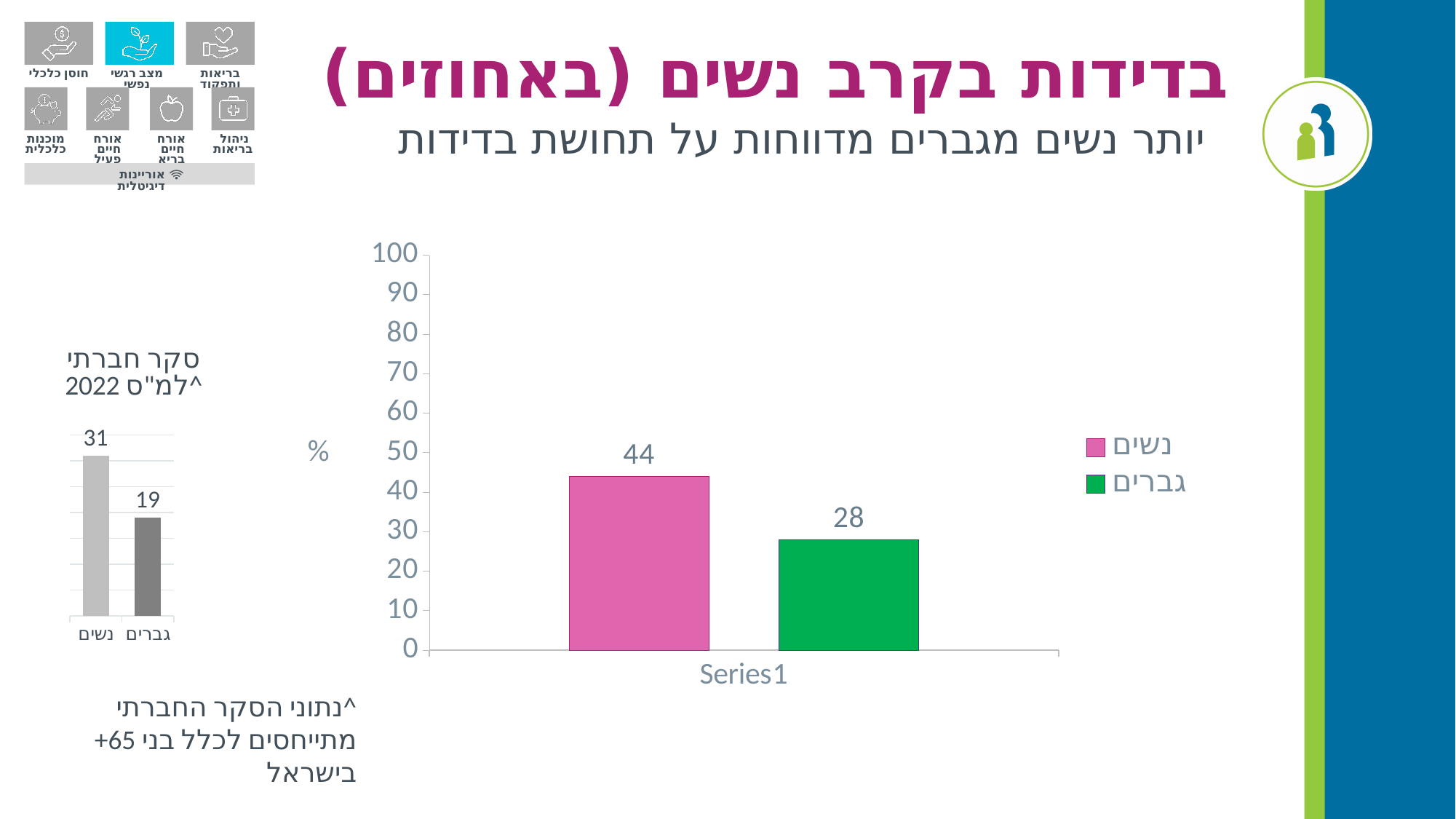
How many series does the legend of the large chart in the centre of the slide list? 2 In the large chart in the centre of the slide, what is the value for נשים? 44 In the small chart on the left titled סקר חברתי למ"ס 2022, what is the value for נשים? 31 In the large chart in the centre of the slide, which series has the higher value, נשים or גברים? נשים In the large chart in the centre of the slide, what colour is the bar for נשים? pink In the large chart in the centre of the slide, what is the difference between the values for נשים and גברים? 16 What kind of chart is the large chart in the centre of the slide? bar chart In the small chart on the left titled סקר חברתי למ"ס 2022, what is the difference between the values for נשים and גברים? 12 In the small chart on the left titled סקר חברתי למ"ס 2022, what is the value for גברים? 19 In the large chart in the centre of the slide, what is the value for גברים? 28 In the small chart on the left titled סקר חברתי למ"ס 2022, which category has the lowest value? גברים In the large chart in the centre of the slide, what is the category label shown on the x axis? Series1